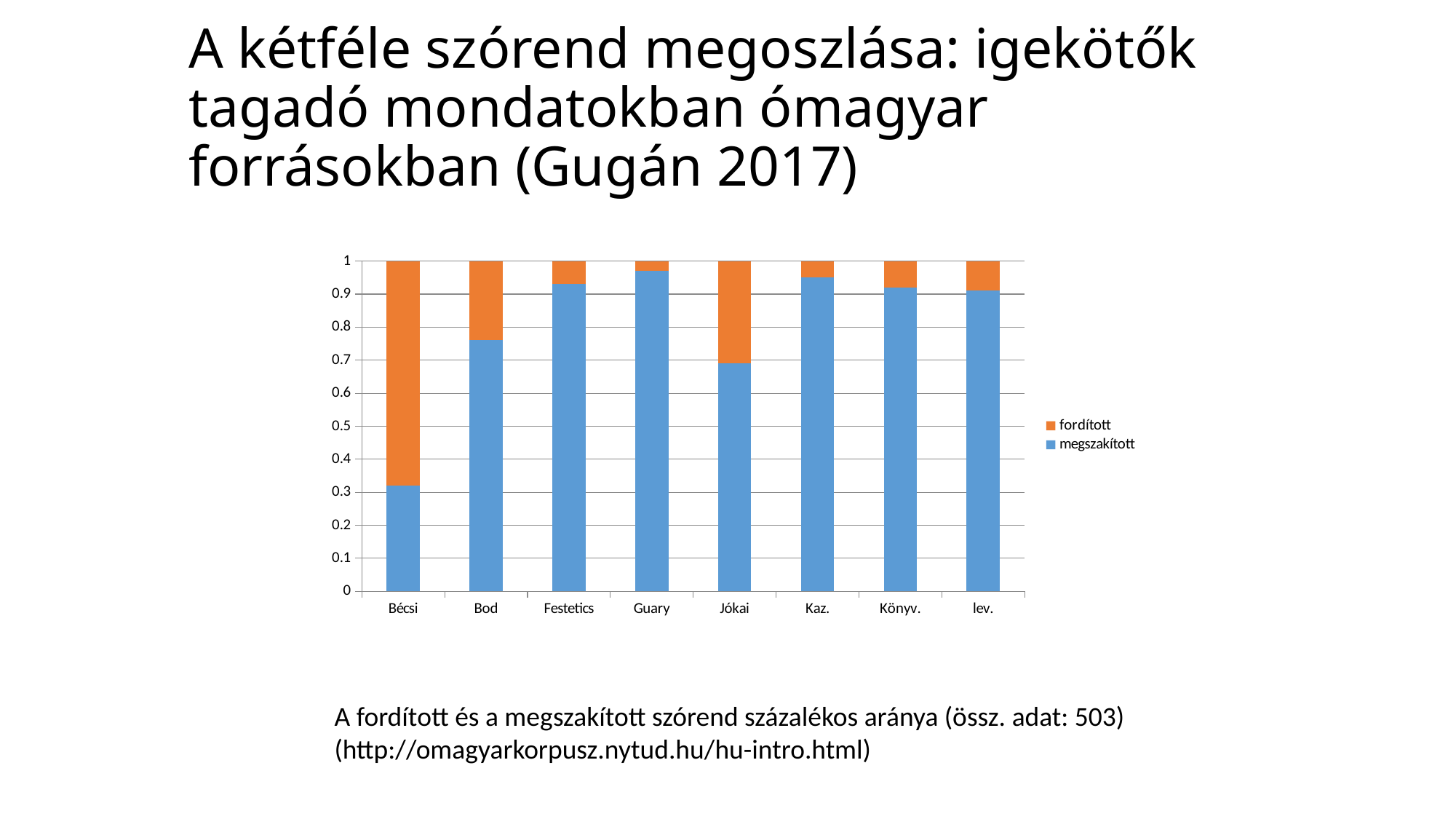
How many categories (sources) are shown on the x axis? 8 Which has the larger megszakított value, Bod or Jókai? Bod How many series does the legend list? 2 What kind of chart is shown on the slide? stacked bar chart Which category has the lowest value for megszakított? Bécsi Is the megszakított value for Bécsi greater or less than 0.4? less Which series is shown in orange? fordított Is the megszakított value for Jókai greater or less than 0.6? greater Which category has the highest value for fordított? Bécsi Is the megszakított value for Bod greater or less than 0.7? greater What is the total height of the stacked bar for Festetics? 1